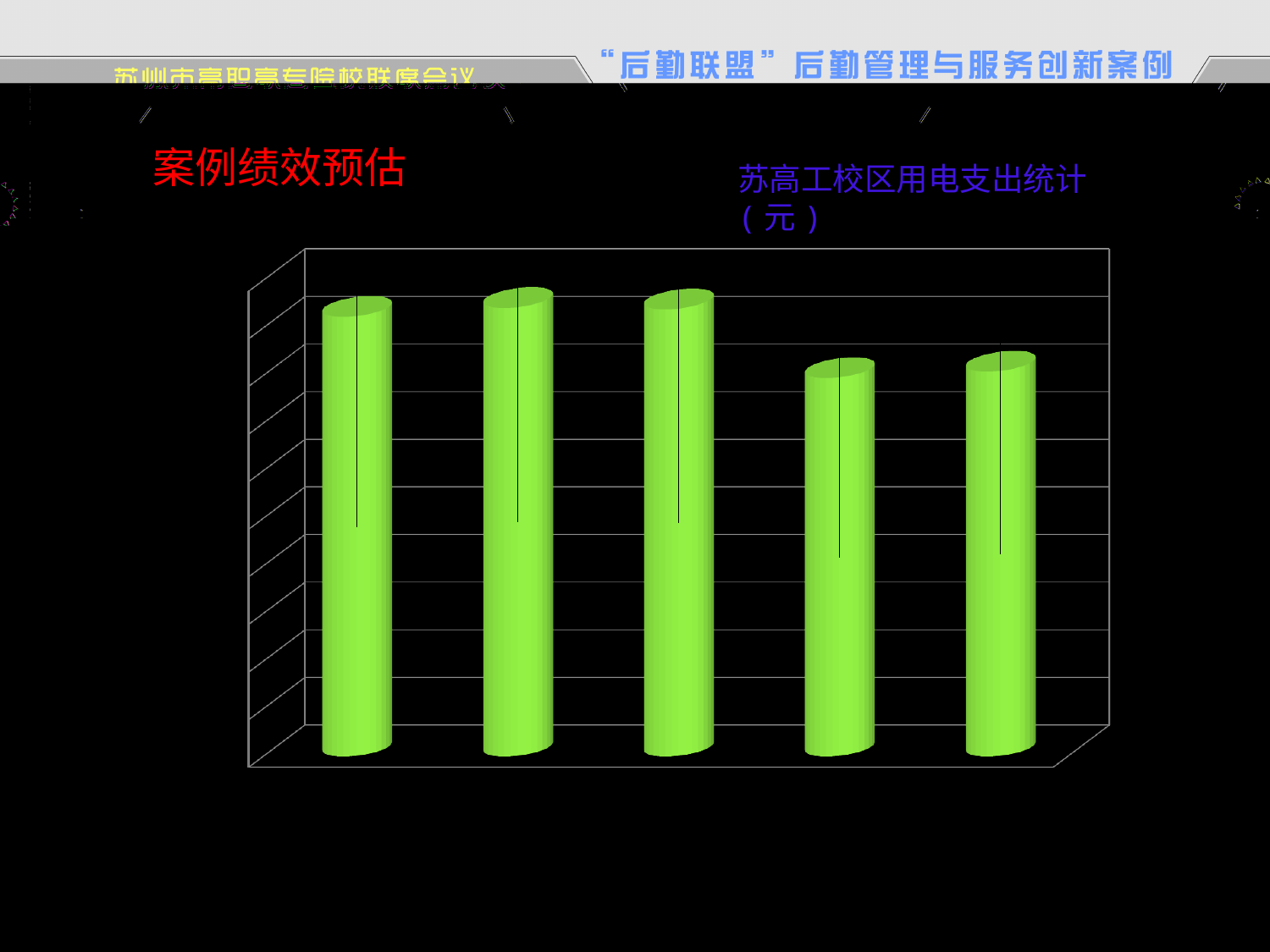
Which is larger, the third bar from the left or the fifth bar from the left? the third bar Do the bar heights overall rise or fall from left to right across the chart? fall Which is larger, the first bar from the left or the fourth bar from the left? the first bar What colour are the bars in the chart? green What kind of chart is shown on the slide? bar chart How many bars does the chart contain? 5 What is the title of the chart? 苏高工校区用电支出统计（元）